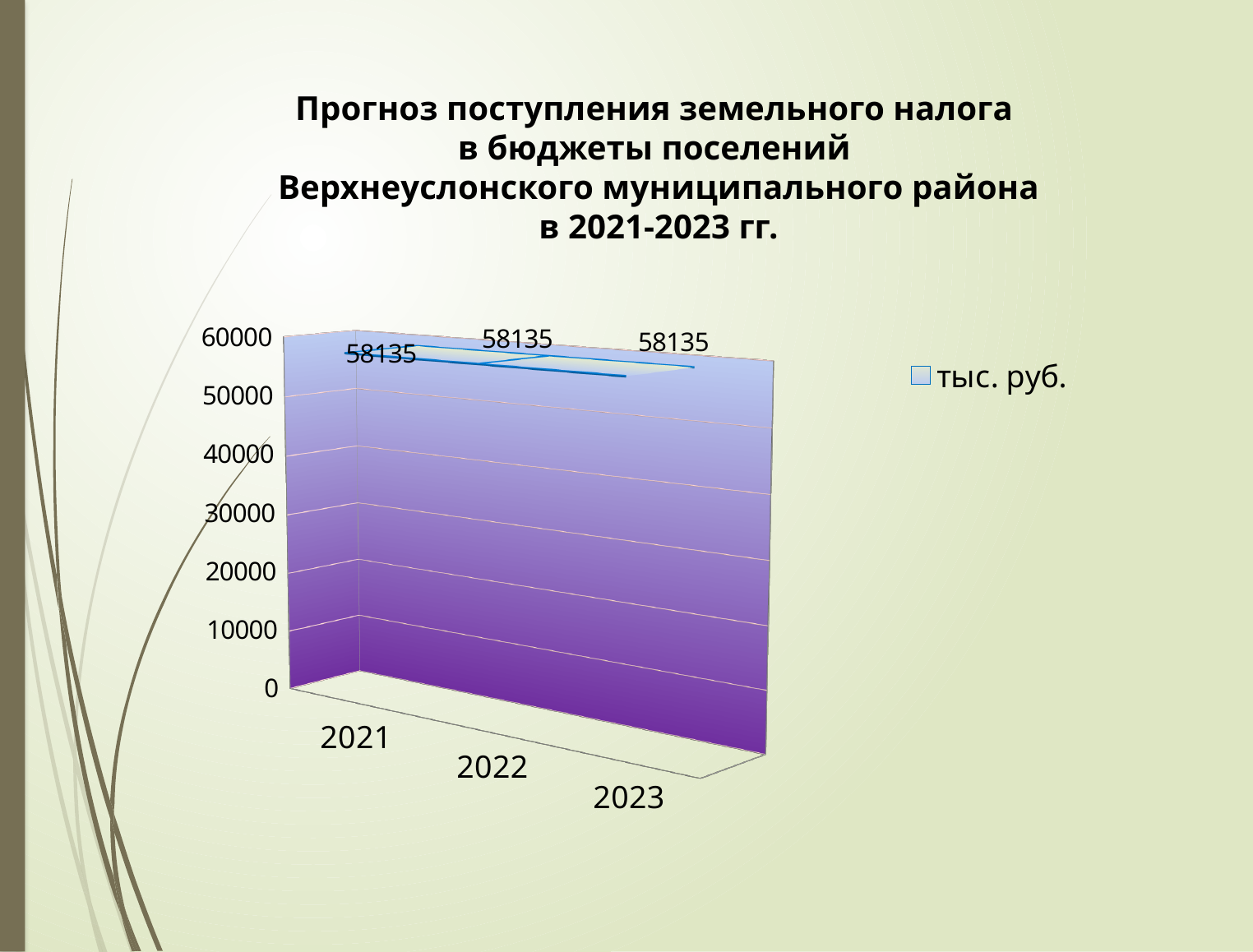
Is the value for 2022 greater or less than 50000? greater Is the value for 2021 greater or less than 60000? less What is the forecast land tax value for 2023? 58135 What kind of chart is shown on the slide? line chart How many series does the legend list? 1 What is the forecast land tax value for 2021? 58135 What is the difference between the values for 2023 and 2021? 0 How many years are shown on the x axis of the chart? 3 What is the forecast land tax value for 2022? 58135 What is the name of the series shown in the legend? тыс. руб. Do the values rise, fall or stay the same from 2021 to 2023? stay the same What is the highest value shown on the vertical axis? 60000